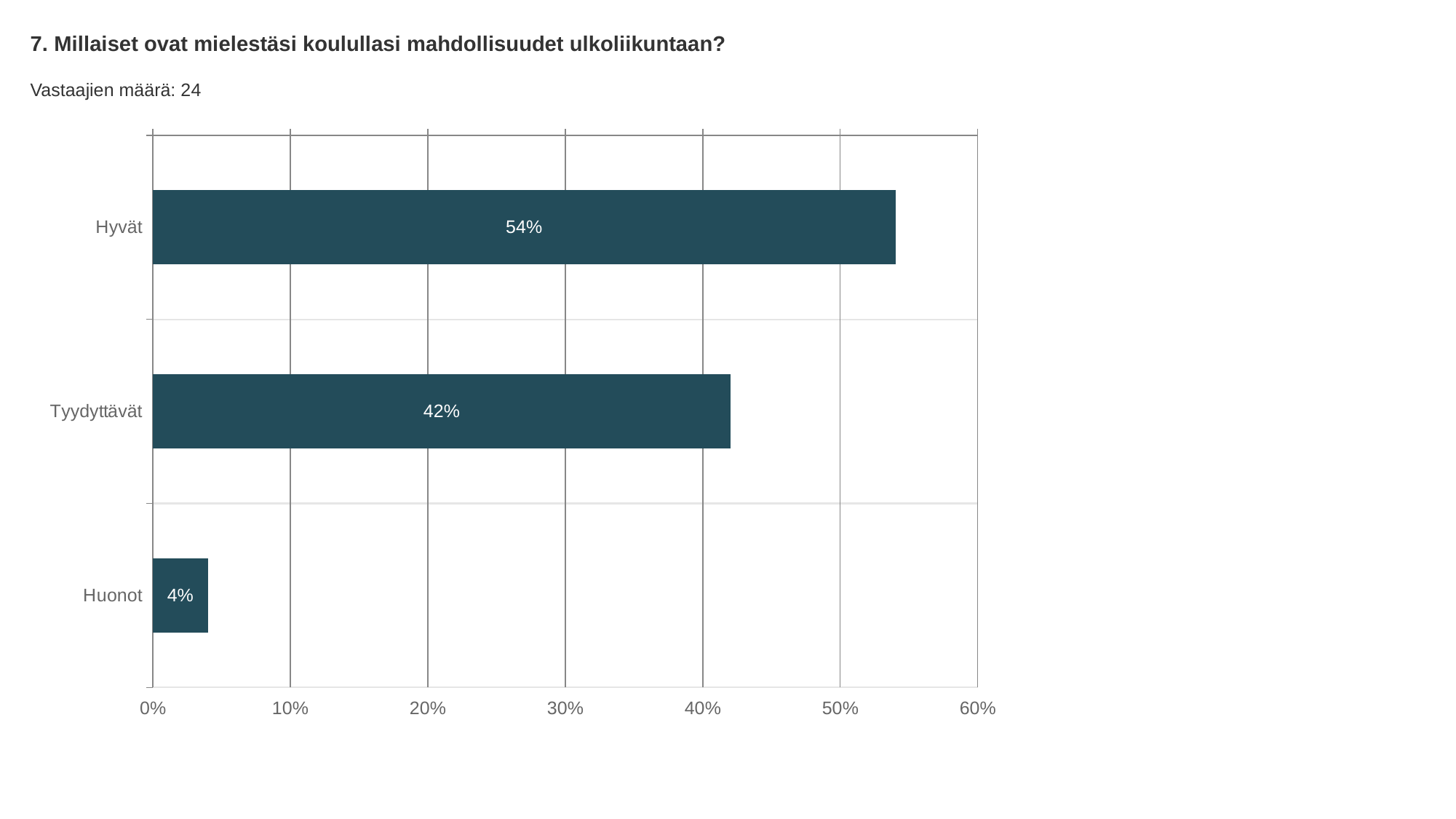
What is the value for Tyydyttävät? 42% Is the value for Hyvät greater or less than 50%? greater How many categories are shown in the chart? 3 Which category has the lowest value? Huonot Which is larger, the value for Hyvät or the value for Tyydyttävät? Hyvät What is the difference between the values for Tyydyttävät and Huonot? 38% What is the difference between the values for Hyvät and Tyydyttävät? 12% What is the value for Huonot? 4% What is the value for Hyvät? 54% What kind of chart is shown on the slide? bar chart Which category has the highest value? Hyvät How many respondents (Vastaajien määrä) does the slide report? 24